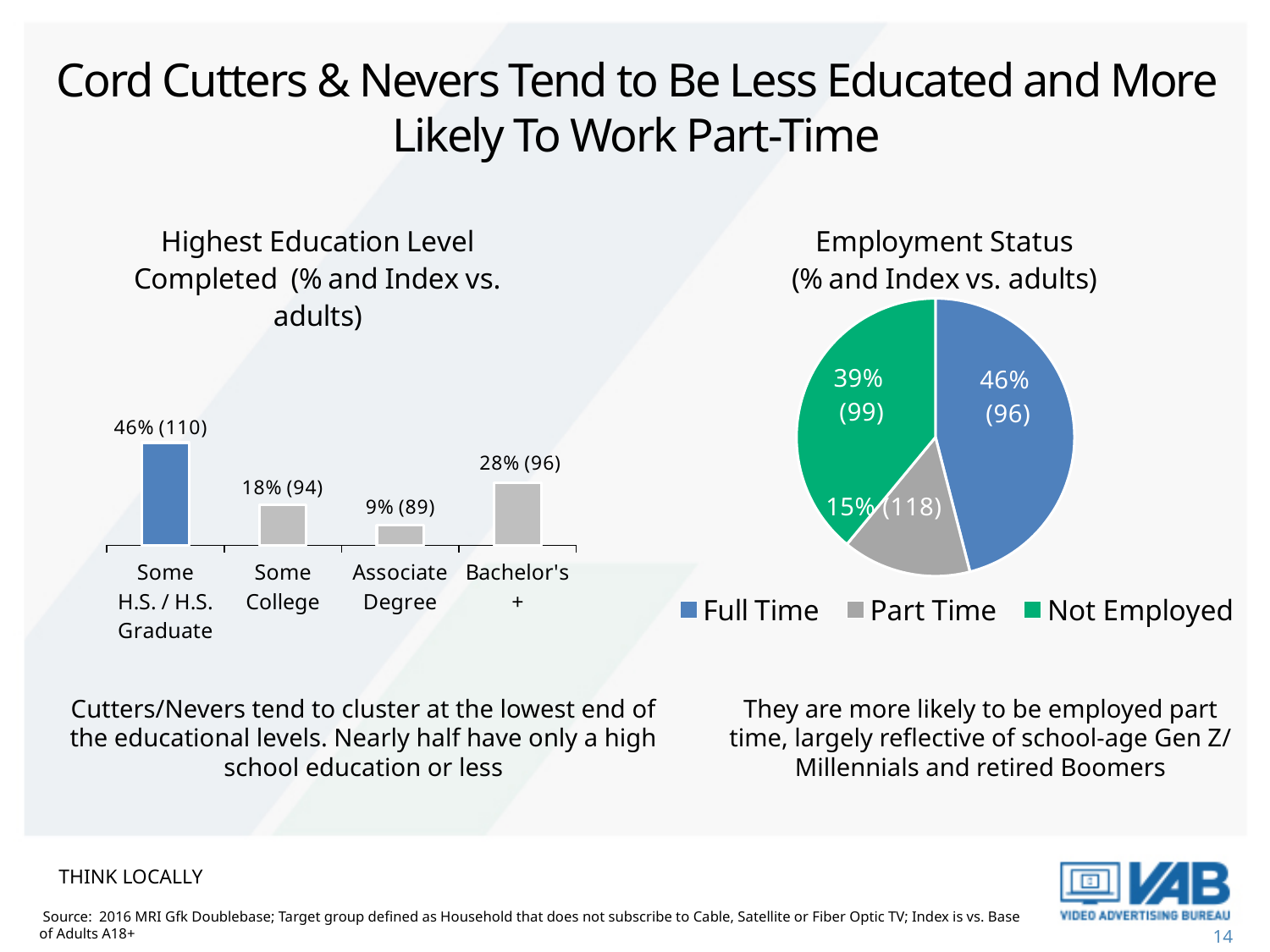
How many categories are shown in the Highest Education Level Completed chart? 4 In the Employment Status chart, what colour is the Not Employed slice? Green In the Highest Education Level Completed chart, which category has the highest value? Some H.S. / H.S. Graduate In the Highest Education Level Completed chart, what is the data label for Some H.S. / H.S. Graduate? 46% (110) In the Employment Status chart, what is the data label for Part Time? 15% (118) What kind of chart is the Highest Education Level Completed chart? Bar chart In the Highest Education Level Completed chart, which category has the lowest value? Associate Degree How many series does the legend of the Employment Status chart list? 3 In the Highest Education Level Completed chart, what is the data label for Bachelor's +? 28% (96) In the Employment Status chart, which slice is the largest? Full Time In the Highest Education Level Completed chart, which is larger: Some College or Bachelor's +? Bachelor's + In the Highest Education Level Completed chart, what is the difference in percentage between Some College and Associate Degree? 9%